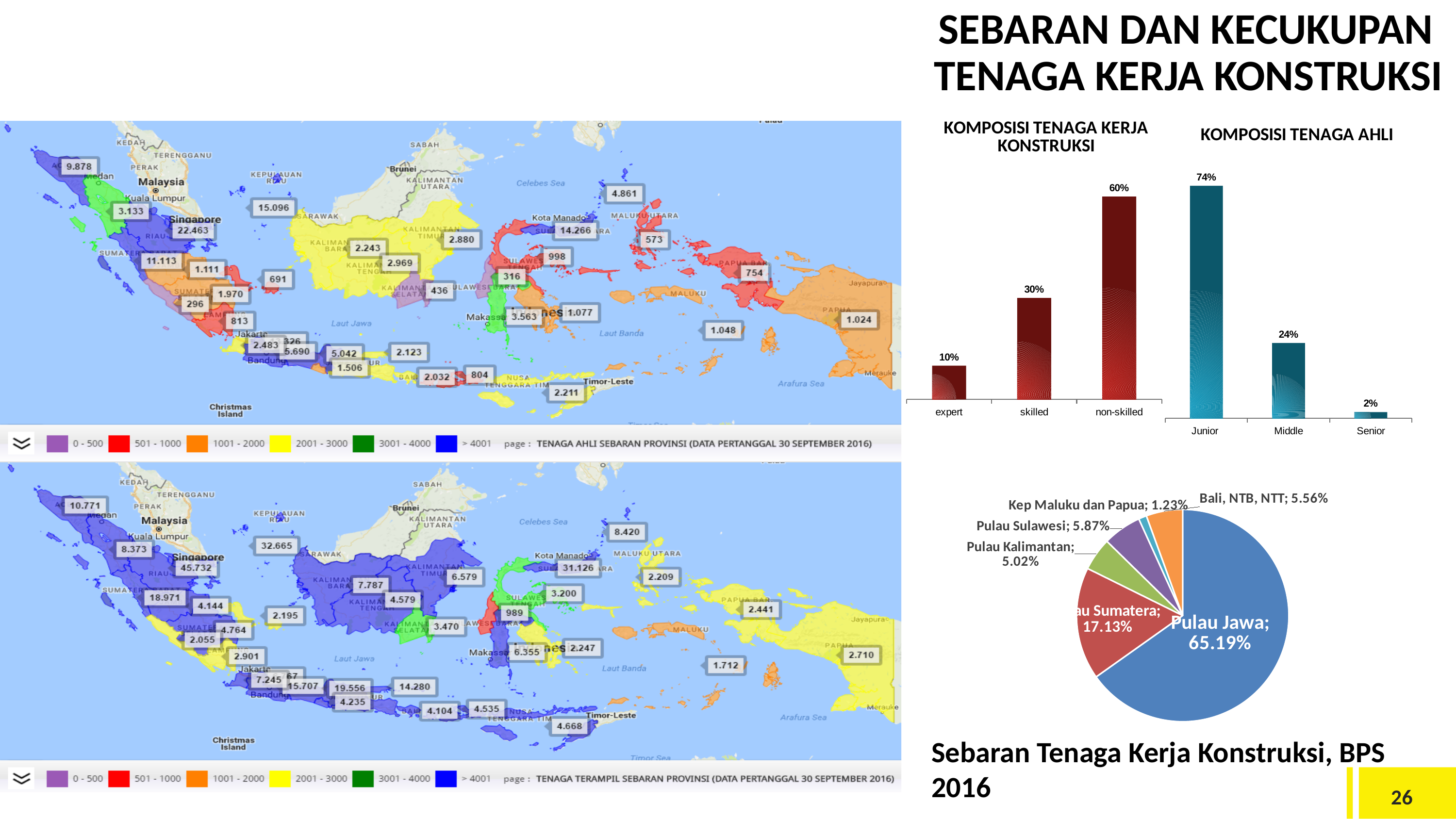
In the KOMPOSISI TENAGA KERJA KONSTRUKSI chart, what is the value for expert? 10% In the KOMPOSISI TENAGA KERJA KONSTRUKSI chart, what is the difference between non-skilled and skilled? 30% In the KOMPOSISI TENAGA KERJA KONSTRUKSI chart, what is the value for non-skilled? 60% In the KOMPOSISI TENAGA AHLI chart, which category has the highest value? Junior In the Sebaran Tenaga Kerja Konstruksi pie chart, which slice is the smallest? Kep Maluku dan Papua In the KOMPOSISI TENAGA AHLI chart, what is the difference between Middle and Senior? 22% How many slices does the Sebaran Tenaga Kerja Konstruksi pie chart have? 6 In the Sebaran Tenaga Kerja Konstruksi pie chart, what share does Pulau Jawa have? 65.19% In the KOMPOSISI TENAGA AHLI chart, what is the value for Junior? 74% In the KOMPOSISI TENAGA KERJA KONSTRUKSI chart, which category has the lowest value? expert In the KOMPOSISI TENAGA AHLI chart, do the values rise or fall from Junior to Senior? fall What kind of chart is the KOMPOSISI TENAGA AHLI chart? bar chart